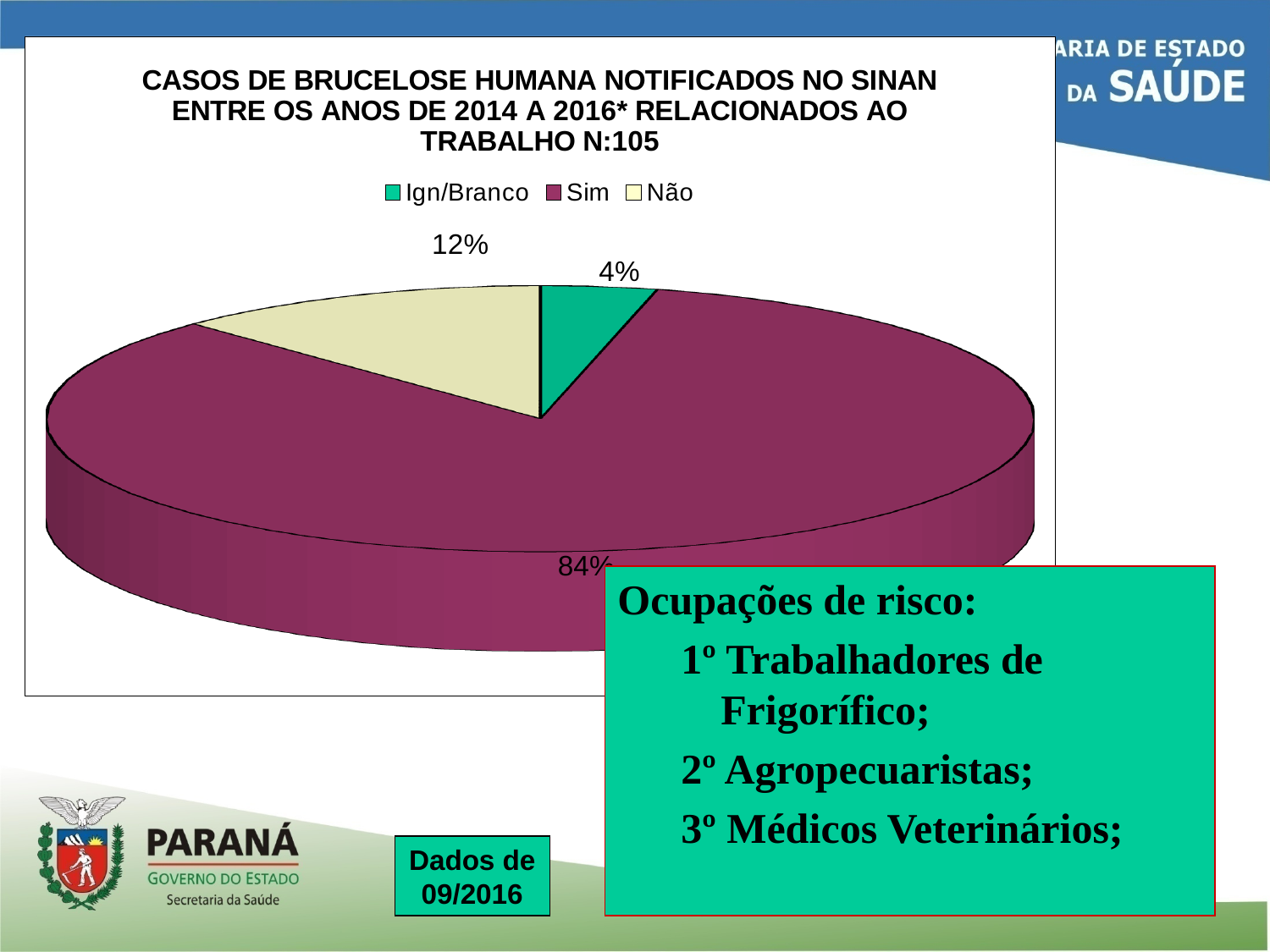
How many entries does the legend list? 3 What is the total number of cases (N) stated in the chart title? 105 How many slices does the pie chart have? 3 What is the difference in percentage points between the "Sim" and "Não" slices? 72 Which category has the smallest slice of the pie? Ign/Branco Which category has the largest slice of the pie? Sim What share of the pie does the "Não" slice represent? 12% Which colour represents the "Sim" category in the pie chart? Magenta/purple What share of the pie does the "Ign/Branco" slice represent? 4% What share of the pie does the "Sim" slice represent? 84% What kind of chart is shown on the slide? Pie chart Which slice is larger, "Não" or "Ign/Branco"? Não